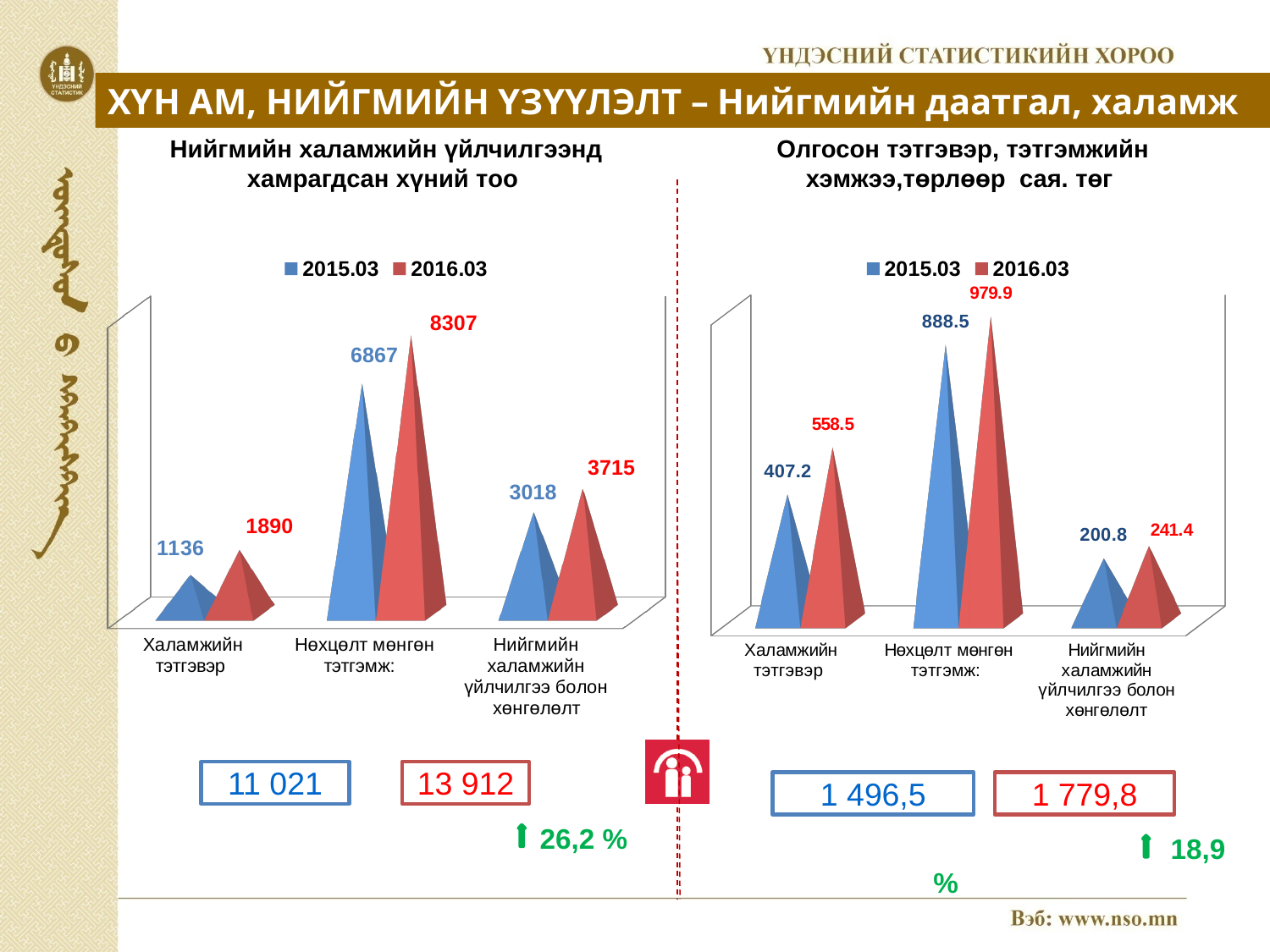
What type of chart is the right chart? Bar chart How many series does the legend of the left chart list? 2 In the right chart, what is the difference between the 2016.03 and 2015.03 values for Халамжийн тэтгэвэр? 151.3 In the left chart, which category has the highest 2016.03 value? Нөхцөлт мөнгөн тэтгэмж How many categories are shown on the x axis of the right chart? 3 In the right chart (Олгосон тэтгэвэр, тэтгэмжийн хэмжээ), what is the 2016.03 value for Нийгмийн халамжийн үйлчилгээ болон хөнгөлөлт? 241.4 In the left chart, which is larger for Нийгмийн халамжийн үйлчилгээ болон хөнгөлөлт: the 2015.03 value or the 2016.03 value? 2016.03 In the right chart, which category has the lowest 2015.03 value? Нийгмийн халамжийн үйлчилгээ болон хөнгөлөлт In the left chart, what is the 2015.03 value for Халамжийн тэтгэвэр? 1136 In the left chart, what is the difference between the 2016.03 and 2015.03 values for Халамжийн тэтгэвэр? 754 In the right chart, what is the 2015.03 value for Нөхцөлт мөнгөн тэтгэмж? 888.5 In the left chart (Нийгмийн халамжийн үйлчилгээнд хамрагдсан хүний тоо), what is the 2016.03 value for Нөхцөлт мөнгөн тэтгэмж? 8307